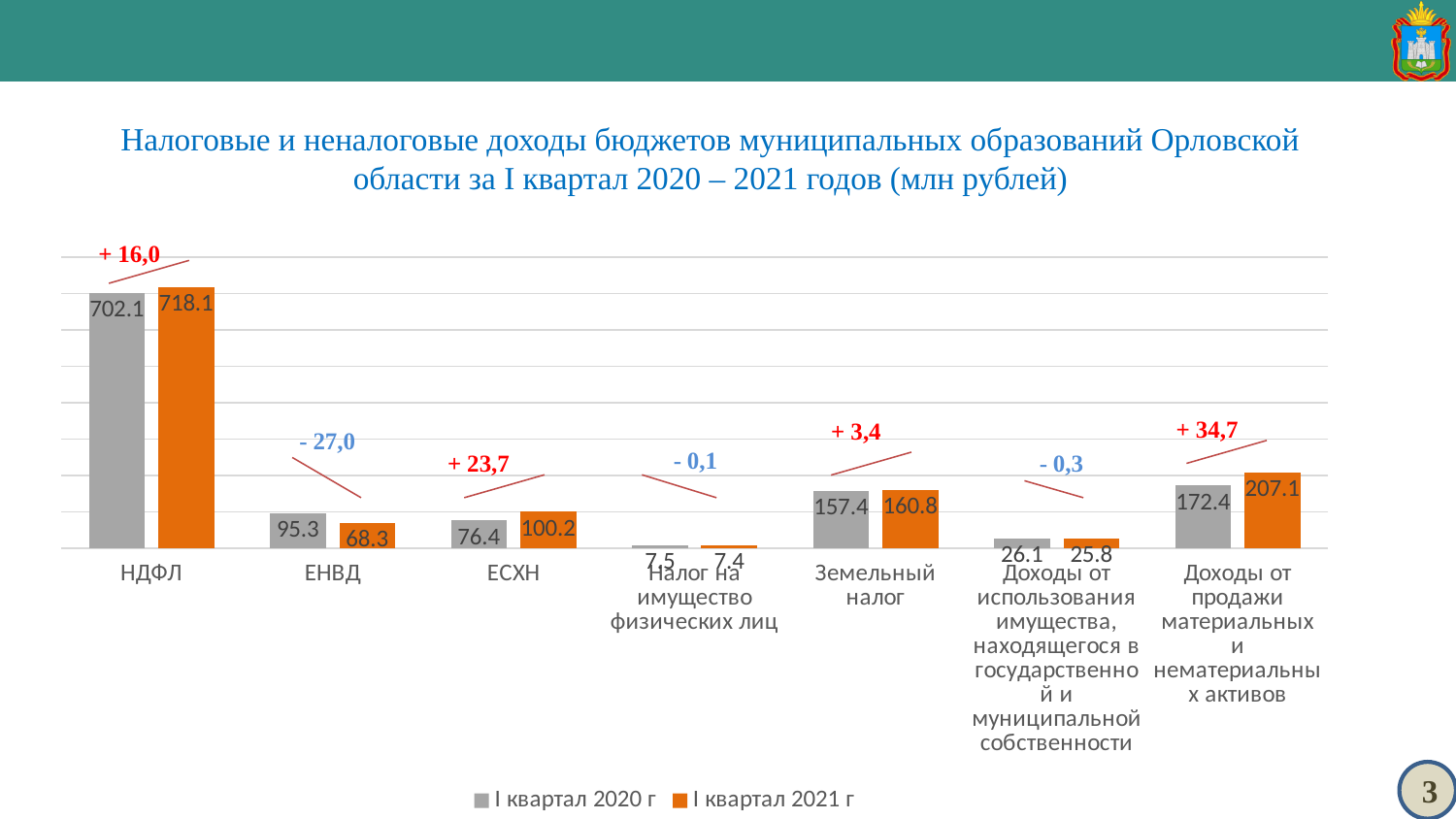
How many categories are shown on the x axis of the chart? 7 What is the value for НДФЛ in the I квартал 2021 г series? 718.1 What is the value for Земельный налог in the I квартал 2021 г series? 160.8 What is the value for ЕСХН in the I квартал 2020 г series? 76.4 What change annotation is shown above the bars for Доходы от продажи материальных и нематериальных активов? + 34,7 What is the difference between the I квартал 2021 г and I квартал 2020 г values for ЕСХН? 23.8 For ЕНВД, which series has the larger value: I квартал 2020 г or I квартал 2021 г? I квартал 2020 г How many series does the legend list? 2 What is the value for ЕНВД in the I квартал 2020 г series? 95.3 Which category has the lowest value in the I квартал 2021 г series? Налог на имущество физических лиц What kind of chart is shown on the slide? Bar chart Which category has the highest value in the I квартал 2020 г series? НДФЛ